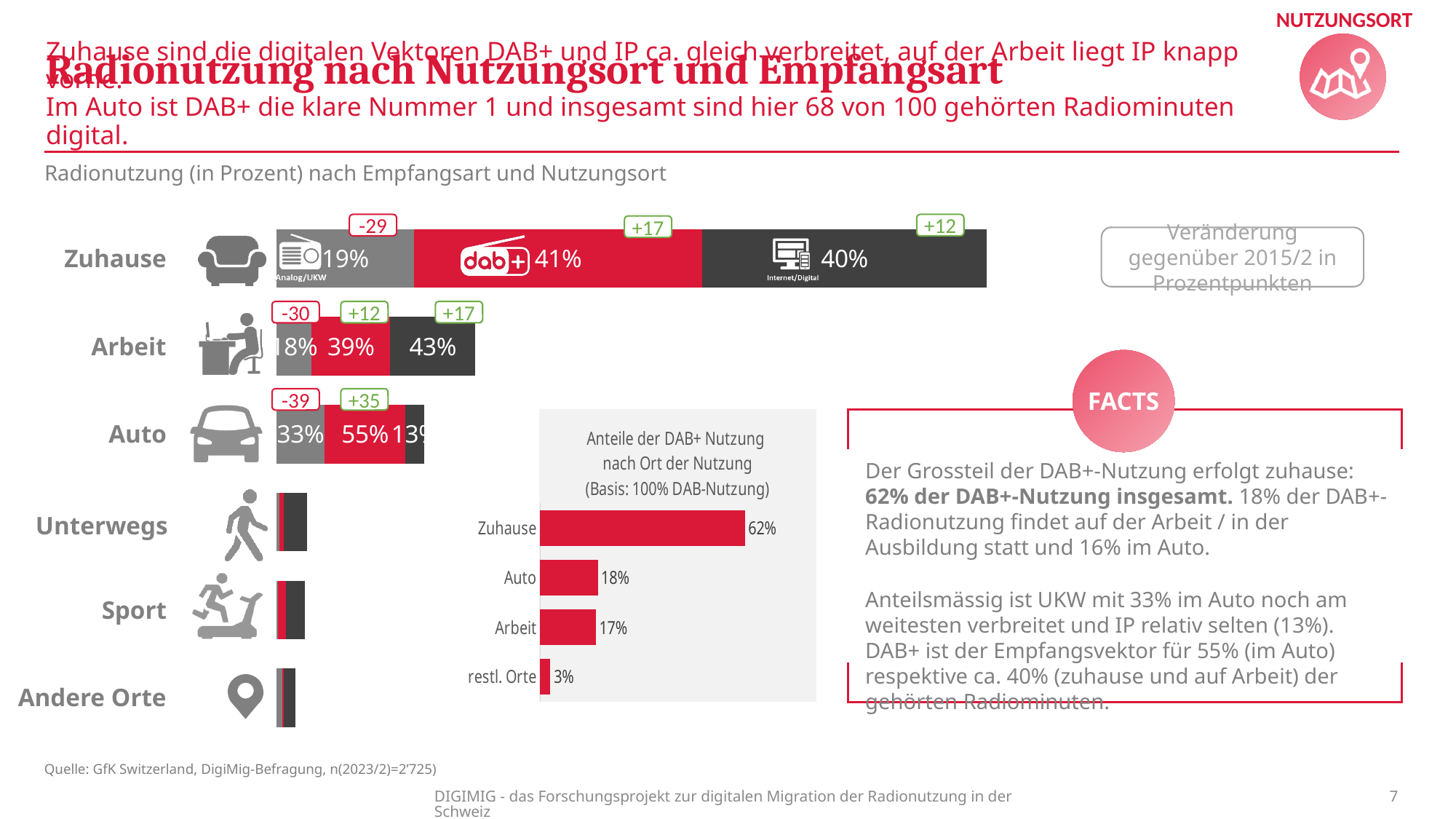
In the main chart 'Radionutzung (in Prozent) nach Empfangsart und Nutzungsort', what is the Analog/UKW share for Zuhause? 19% In the chart 'Anteile der DAB+ Nutzung nach Ort der Nutzung', what is the value for restl. Orte? 3% In the chart 'Anteile der DAB+ Nutzung nach Ort der Nutzung', how many categories are shown? 4 In the chart 'Anteile der DAB+ Nutzung nach Ort der Nutzung', which category has the lowest value? restl. Orte In the chart 'Anteile der DAB+ Nutzung nach Ort der Nutzung', which category has the highest value? Zuhause In the main chart 'Radionutzung (in Prozent) nach Empfangsart und Nutzungsort', what is the DAB+ share for Auto? 55% In the main chart 'Radionutzung (in Prozent) nach Empfangsart und Nutzungsort', what is the change versus 2015/2 shown for DAB+ in the Auto row? +35 In the chart 'Anteile der DAB+ Nutzung nach Ort der Nutzung', what is the difference between the values for Zuhause and Auto? 44 percentage points In the main chart 'Radionutzung (in Prozent) nach Empfangsart und Nutzungsort', what is the Internet/Digital share for Arbeit? 43% In the main chart 'Radionutzung (in Prozent) nach Empfangsart und Nutzungsort', which is larger for Zuhause: the DAB+ share or the Analog/UKW share? DAB+ share What kind of chart is 'Anteile der DAB+ Nutzung nach Ort der Nutzung'? Bar chart In the chart 'Anteile der DAB+ Nutzung nach Ort der Nutzung', what is the value for Zuhause? 62%